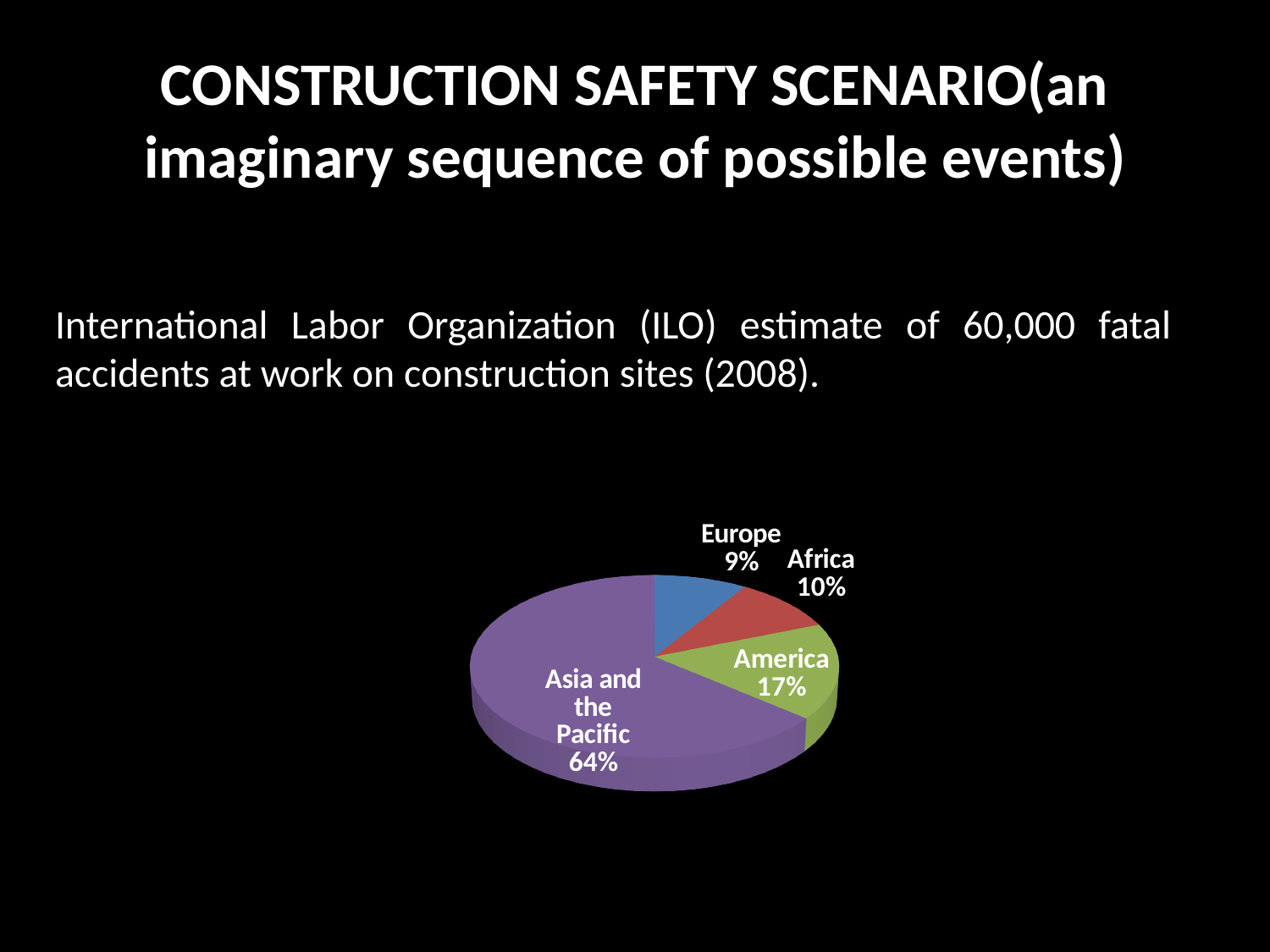
What is the difference in percentage points between America and Africa? 7% What kind of chart is shown on the slide? Pie chart Which is larger, the slice for America or the slice for Europe? America What share of the pie does Asia and the Pacific account for? 64% Which region has the smallest slice of the pie? Europe What is the value shown for Europe? 9% What is the value shown for Africa? 10% What is the value shown for America? 17% How many slices does the pie chart have? 4 Which region has the largest slice of the pie? Asia and the Pacific What colour is the slice for Asia and the Pacific? Purple What is the difference in percentage points between Asia and the Pacific and America? 47%